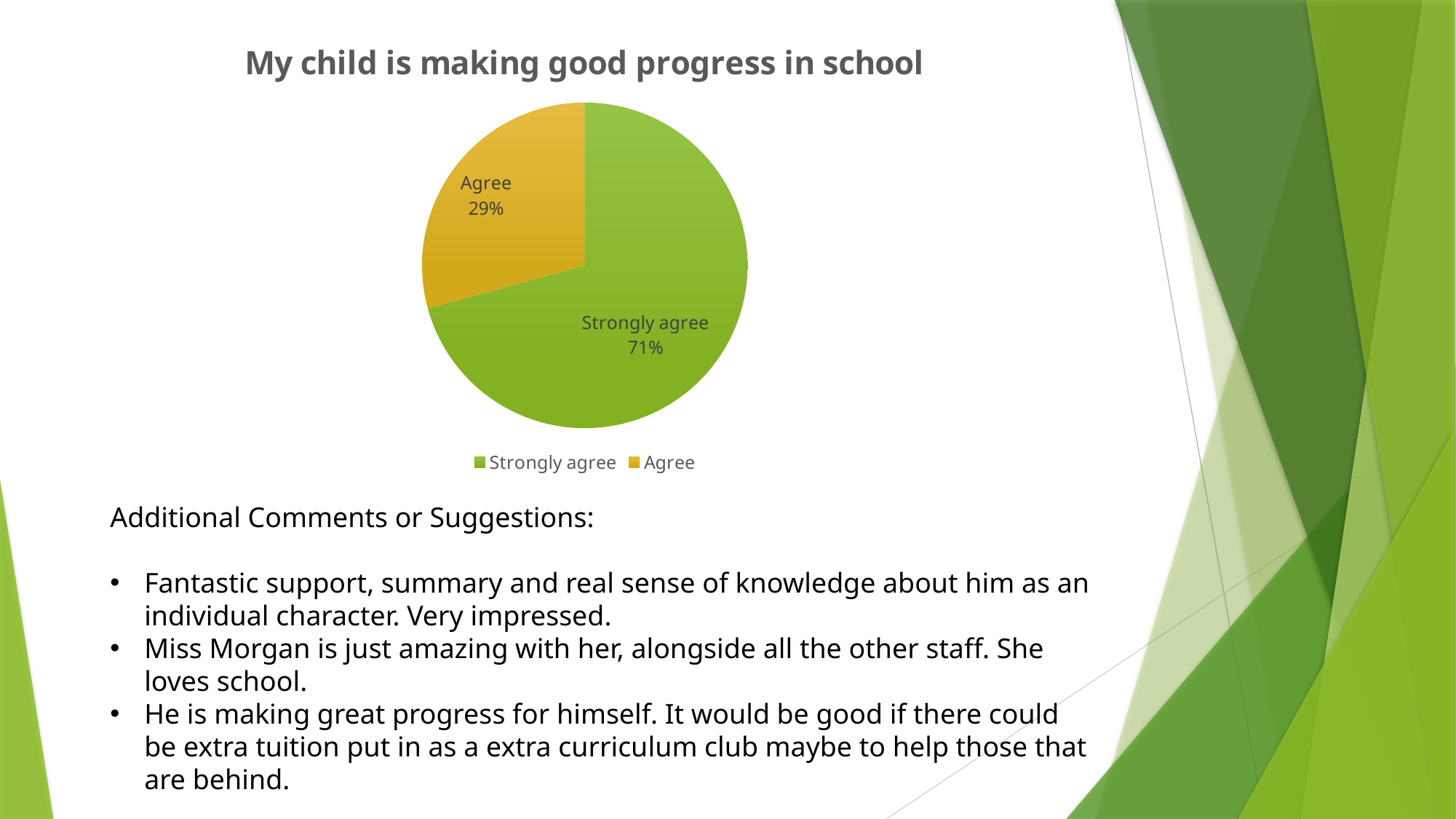
Which response category has the smallest share of the pie? Agree What is the difference in percentage points between 'Strongly agree' and 'Agree'? 42 How many entries does the legend list? 2 Which is larger, the share for 'Agree' or the share for 'Strongly agree'? Strongly agree What kind of chart is shown on the slide? Pie chart What percentage of responses are 'Agree'? 29% Which response category has the largest share of the pie? Strongly agree What percentage of responses are 'Strongly agree'? 71% What is the chart's title? My child is making good progress in school What share of the pie does the 'Strongly agree' slice represent? 71% What colour is the 'Agree' slice? Yellow/gold How many slices does the pie chart have? 2